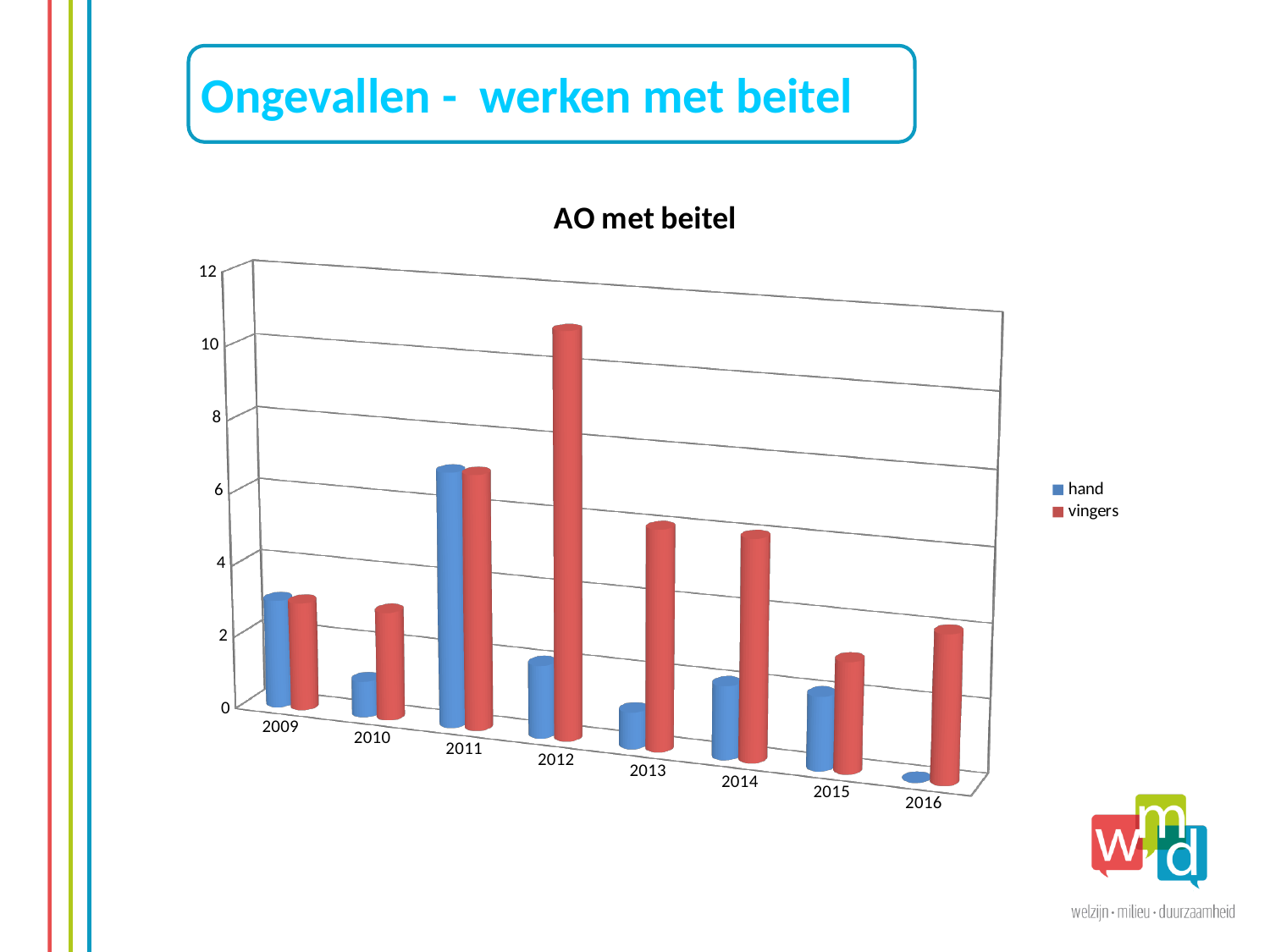
Is the value for hand in 2013 greater or less than 2? less What kind of chart is shown on the slide? bar chart In which year is the value for vingers highest? 2012 How many series does the legend list? 2 Is the value for hand in 2011 greater or less than 4? greater In which year is the value for hand highest? 2011 What is the title of the chart? AO met beitel In 2012, which is larger: the value for hand or the value for vingers? vingers In which year is the value for hand lowest? 2016 How many years are shown on the x axis? 8 Is the value for vingers in 2012 greater or less than 8? greater Which series are listed in the legend? hand, vingers